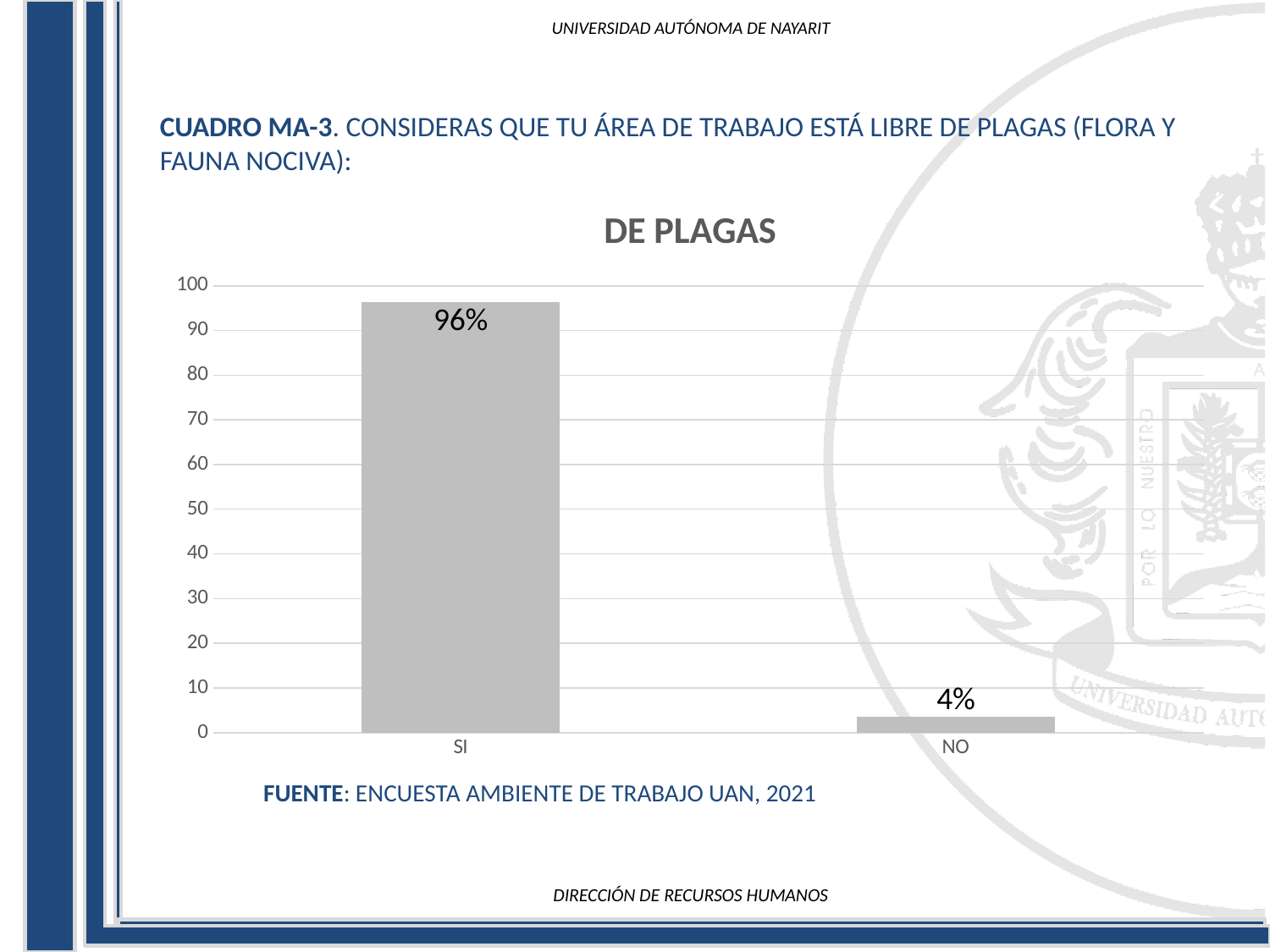
What is the title of the chart? DE PLAGAS Is the value for SI greater or less than 90? greater Is the value for NO greater or less than 10? less Which category has the highest value? SI What is the difference between the values for SI and NO? 92% Which category has the lowest value? NO How many categories are shown on the x axis? 2 What is the value for NO? 4% What is the maximum value shown on the y axis? 100 What is the value for SI? 96% What kind of chart is shown on the slide? bar chart Which is larger, the value for SI or the value for NO? SI